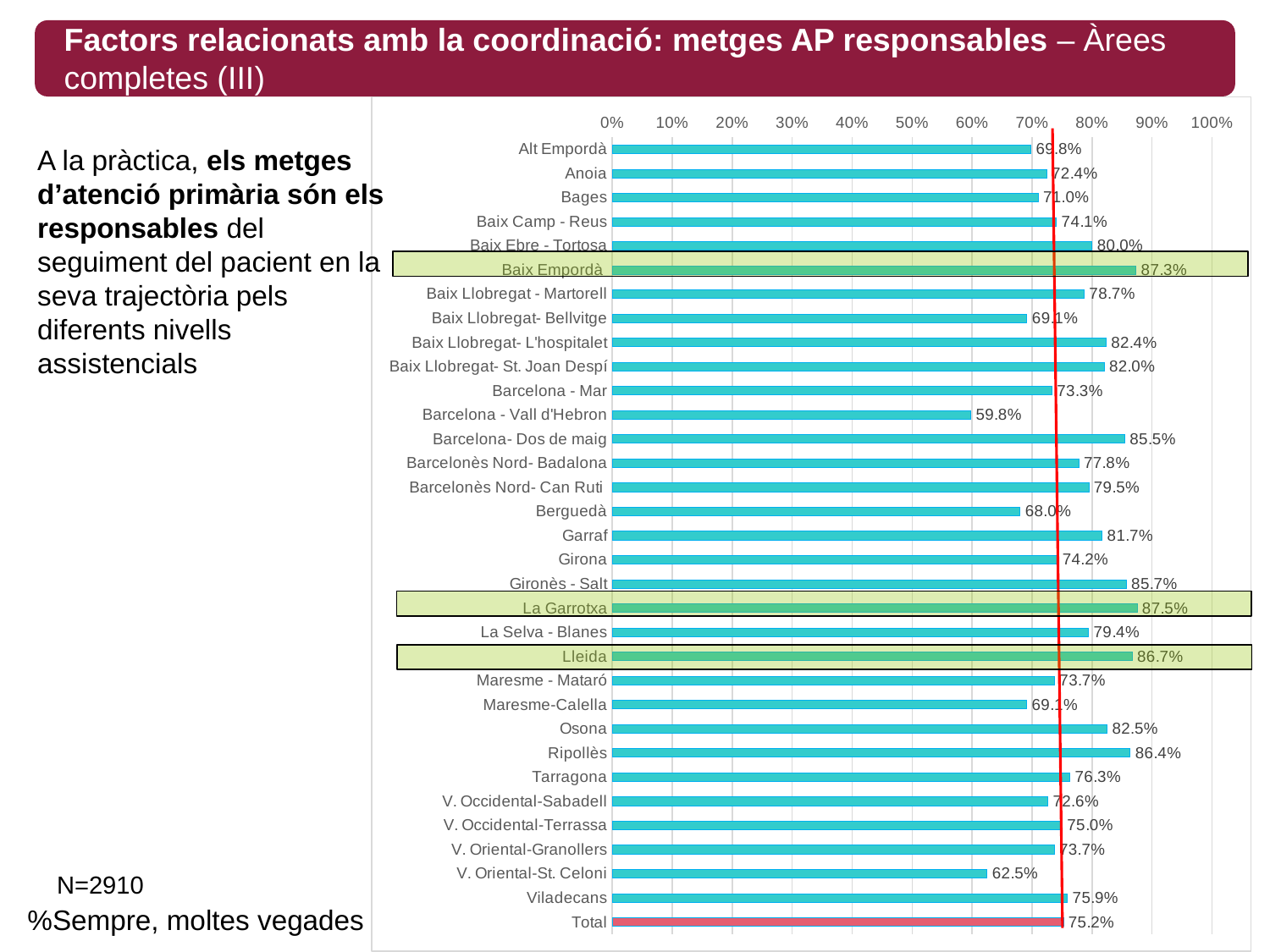
Is the value for V. Oriental-St. Celoni greater or less than 70%? less Which category has the highest value? La Garrotxa What is the value for Total? 75.2% Which is larger, the value for Osona or the value for Garraf? Osona What is the value for Barcelona - Vall d'Hebron? 59.8% What is the difference between the values for Lleida and Total? 11.5% Which category has the lowest value? Barcelona - Vall d'Hebron What is the value for Ripollès? 86.4% What is the difference between the values for Gironès - Salt and Girona? 11.5% What is the value for Baix Empordà? 87.3% What kind of chart is shown on the slide? bar chart How many bars are plotted in the chart, including Total? 33